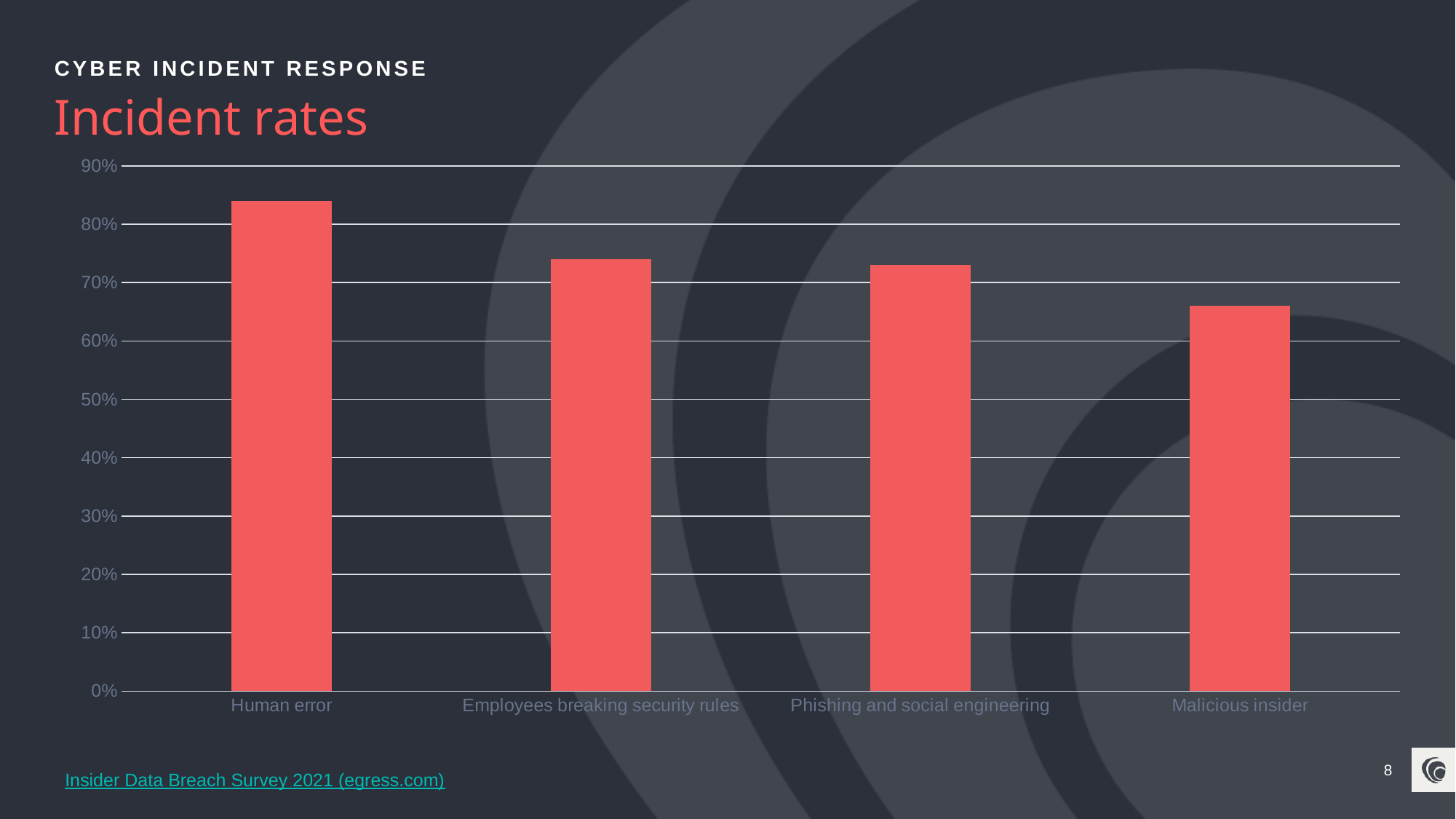
Do the values rise or fall from left to right across the categories? Fall Which is larger, the value for Human error or the value for Malicious insider? Human error What kind of chart is shown on the slide? Bar chart Which category has the highest incident rate? Human error Is the value for Employees breaking security rules greater or less than 70%? greater Which category has the lowest incident rate? Malicious insider Is the value for Phishing and social engineering greater or less than 80%? less How many categories are plotted in the chart? 4 Is the value for Malicious insider greater or less than 70%? less Which is larger, the value for Employees breaking security rules or the value for Malicious insider? Employees breaking security rules What is the title of the chart? Incident rates